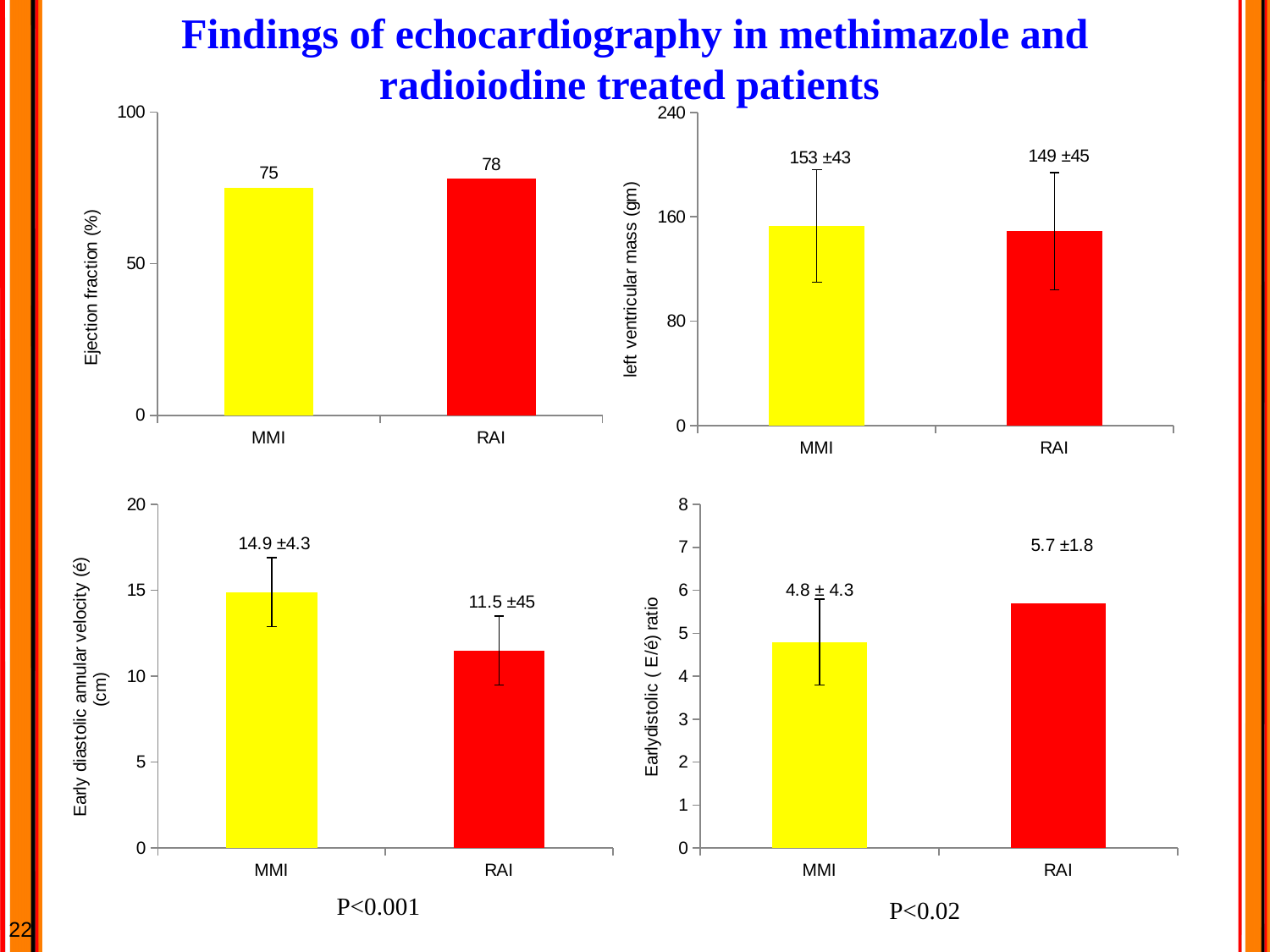
In the bottom-left chart (Early diastolic annular velocity), what is the data label for MMI? 14.9 ±4.3 What P value is printed below the bottom-left chart (Early diastolic annular velocity)? P<0.001 In the top-left chart (Ejection fraction), what is the value for RAI? 78 What type of chart is the top-right chart (left ventricular mass)? Bar chart In the bottom-right chart (E/é ratio), which group has the lower bar? MMI In the bottom-left chart (Early diastolic annular velocity), which group has the higher bar, MMI or RAI? MMI In the top-left chart (Ejection fraction), what is the difference between the RAI and MMI values? 3 How many bars are plotted in the top-left chart (Ejection fraction)? 2 In the top-left chart (Ejection fraction), what is the value for MMI? 75 In the top-right chart (left ventricular mass), what is the data label for MMI? 153 ±43 In the bottom-right chart (E/é ratio), what is the data label for RAI? 5.7 ±1.8 In the top-right chart (left ventricular mass), what is the data label for RAI? 149 ±45